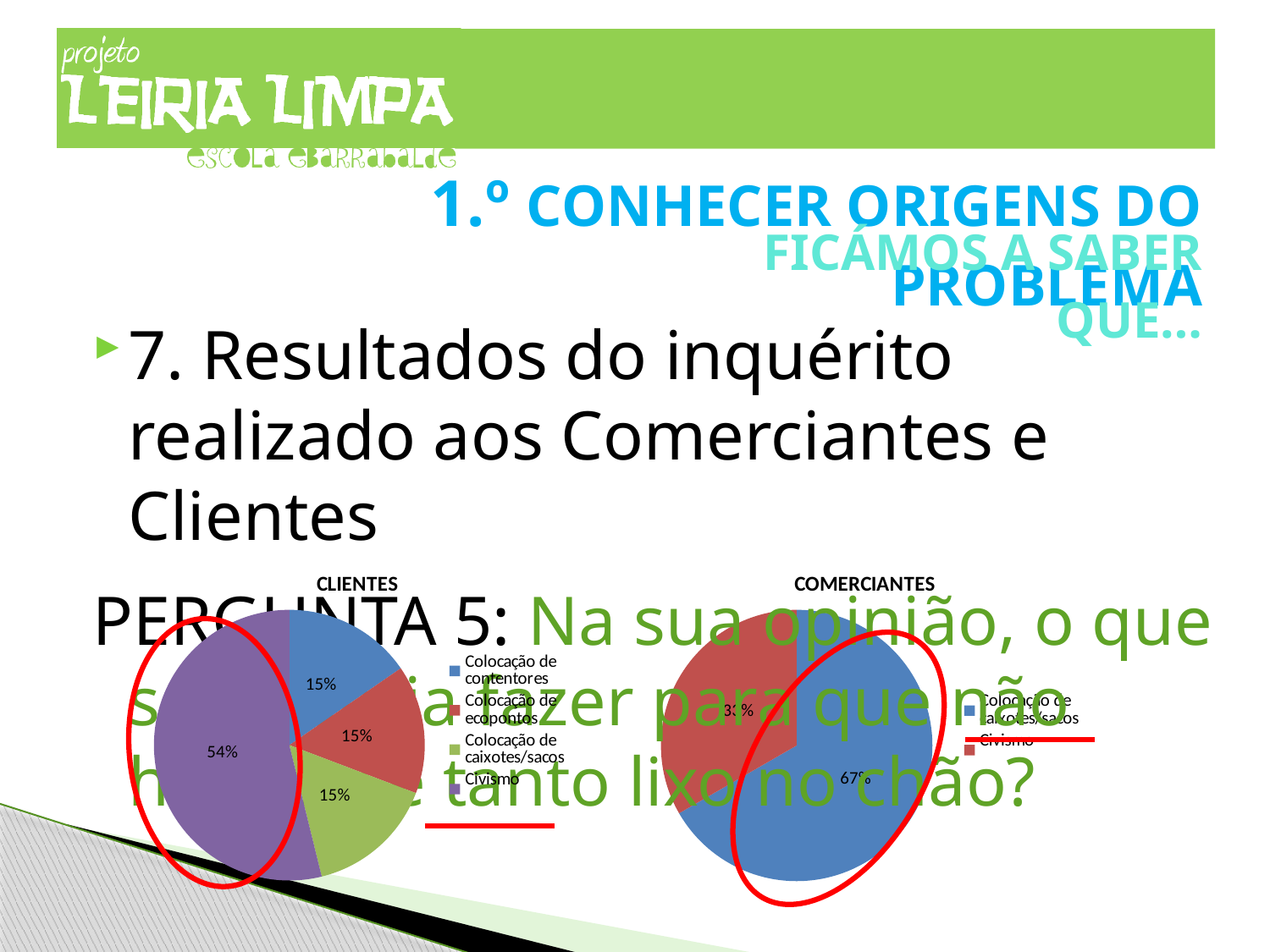
In the CLIENTES chart, which is larger: Civismo or Colocação de ecopontos? Civismo How many entries does the legend of the CLIENTES chart list? 4 How many slices does the COMERCIANTES pie chart have? 2 How many slices does the CLIENTES pie chart have? 4 In the CLIENTES chart, which category has the largest slice? Civismo In the CLIENTES chart, what is the difference between the Civismo slice and the Colocação de contentores slice? 39 percentage points In the COMERCIANTES chart, which category has the largest slice? Colocação de caixotes/sacos In the CLIENTES chart, what percentage is shown for Colocação de contentores? 15% In the CLIENTES chart, what colour is the Civismo slice? purple In the COMERCIANTES chart, what percentage is shown for Colocação de caixotes/sacos? 67% What kind of chart is the CLIENTES chart? pie chart In the CLIENTES chart, what percentage is shown for Civismo? 54%